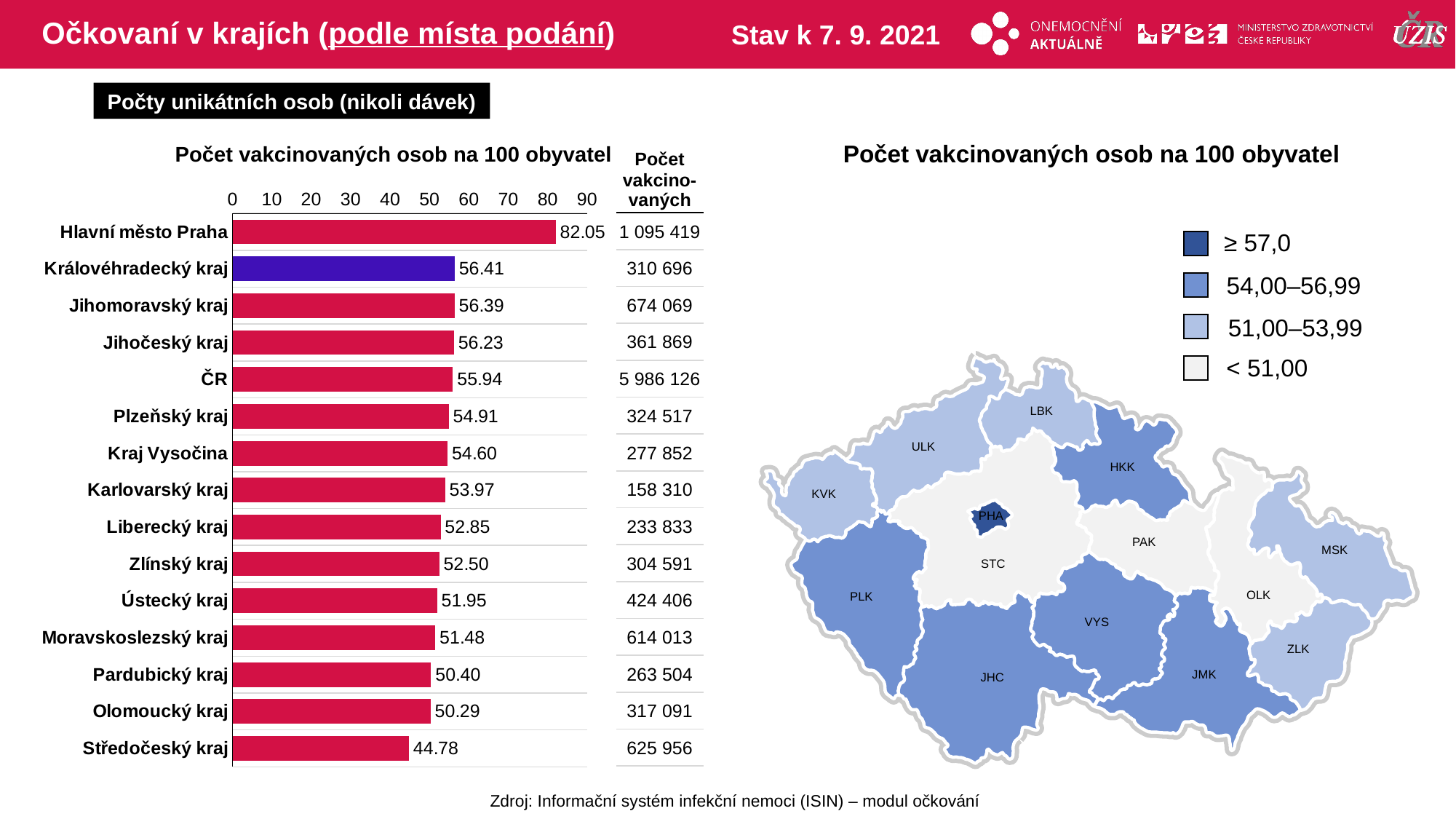
In the bar chart, what is the difference between the values for Hlavní město Praha and Středočeský kraj? 37.27 In the bar chart, what is the value for ČR? 55.94 What kind of chart is shown on the left of the slide? bar chart In the bar chart, what is the value for Hlavní město Praha? 82.05 In the bar chart, which is larger: the value for Plzeňský kraj or the value for Liberecký kraj? Plzeňský kraj What is the title of the bar chart on the left? Počet vakcinovaných osob na 100 obyvatel In the bar chart, which category has the highest value? Hlavní město Praha In the bar chart, which category has the lowest value? Středočeský kraj In the bar chart, what is the value for Kraj Vysočina? 54.60 In the bar chart, which category's bar is coloured differently (blue) from the others? Královéhradecký kraj In the bar chart, is the value for Středočeský kraj greater or less than 50? less How many bars does the bar chart show? 15